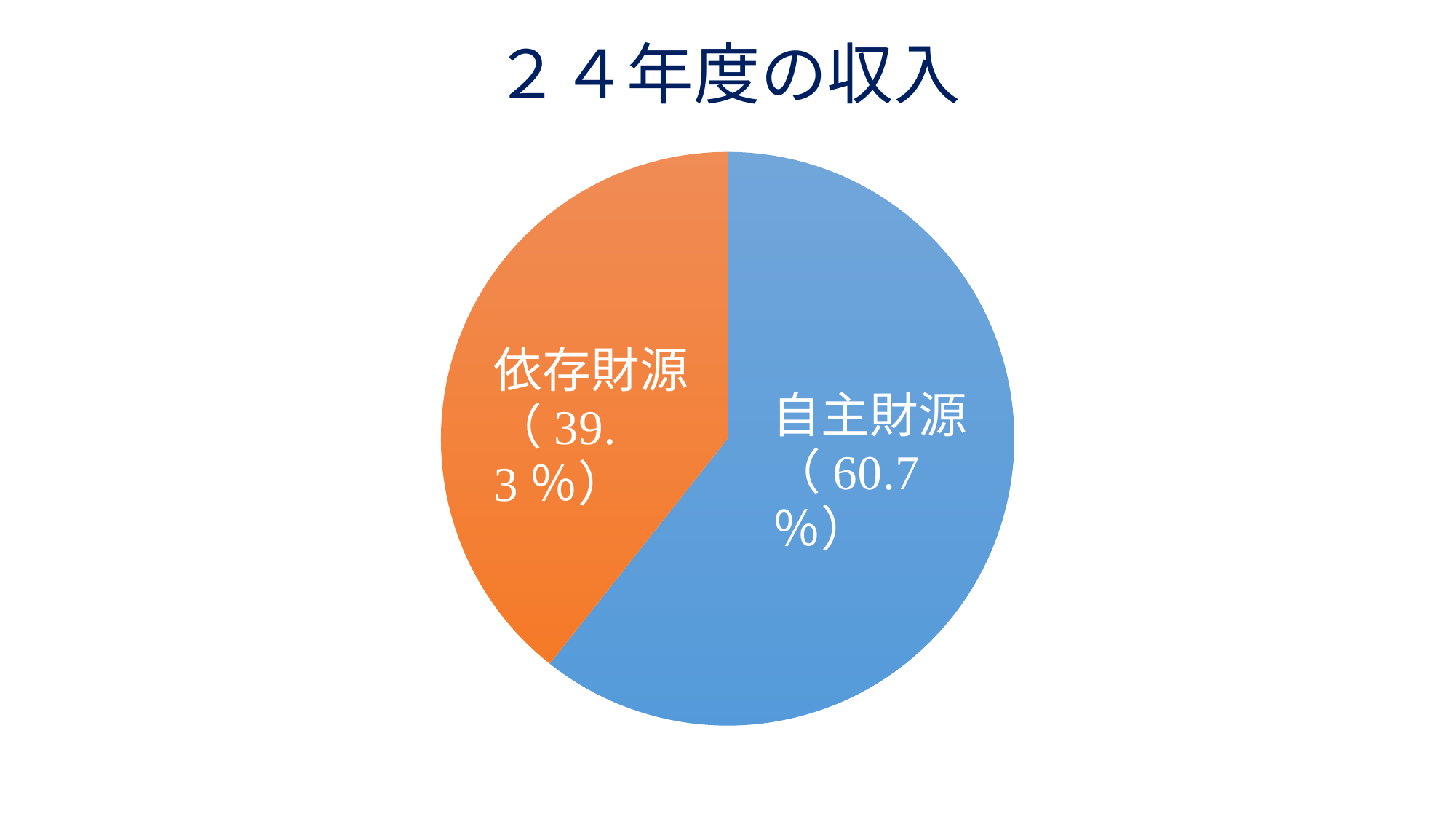
What share of the pie does 依存財源 represent? 39.3% How many slices does the pie chart have? 2 Which slice is the largest? 自主財源 Which is larger, 自主財源 or 依存財源? 自主財源 What colour is the 依存財源 slice? orange What is the title of the chart? ２４年度の収入 What is the difference in percentage points between 自主財源 and 依存財源? 21.4 What kind of chart is shown on the slide? pie chart Which slice is the smallest? 依存財源 What share of the pie does 自主財源 represent? 60.7%